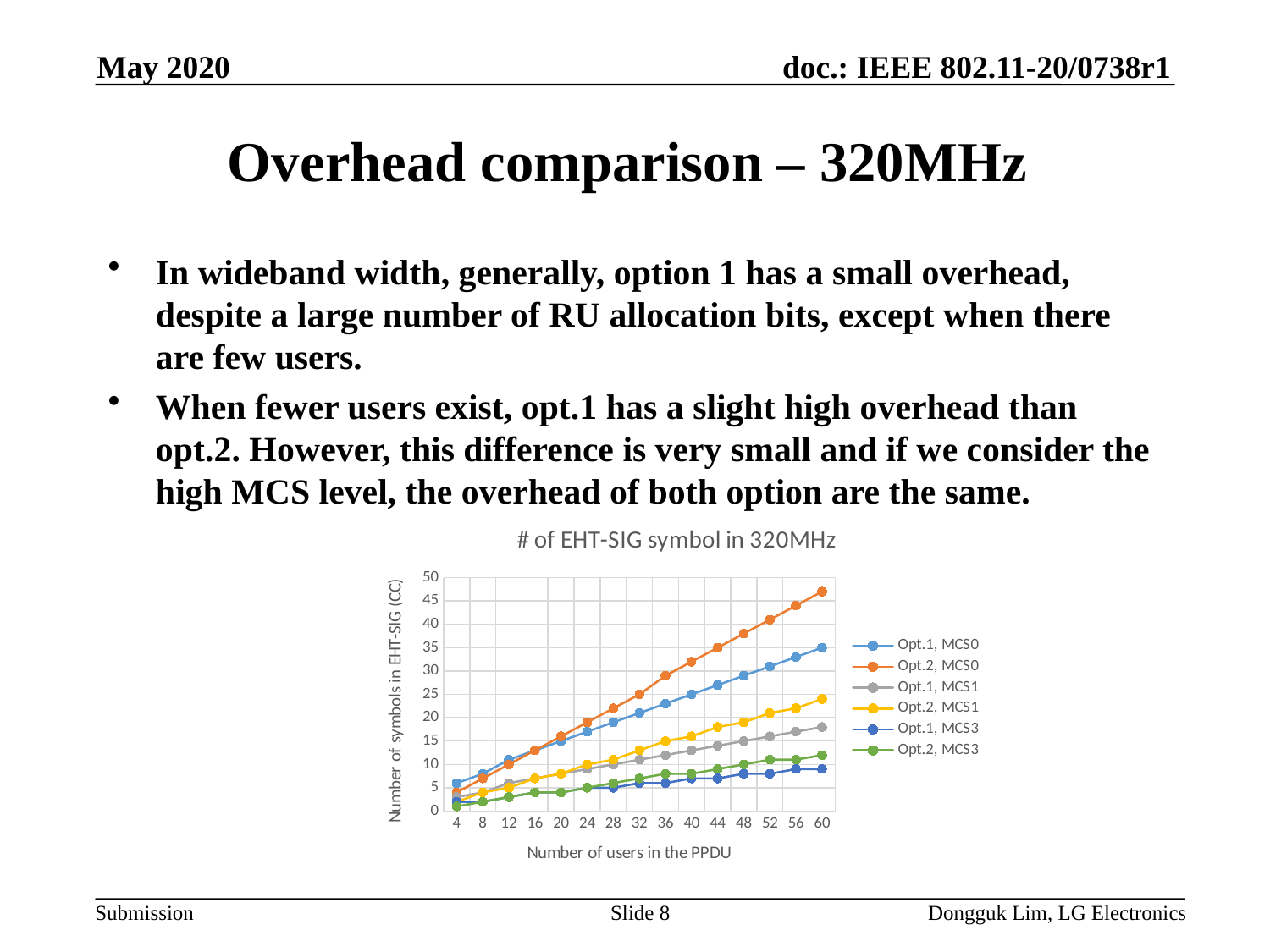
How many points along the x axis (number of users) are plotted for each series? 15 Is the value for Opt.2, MCS0 at 60 users greater or less than 45? greater Do the values for Opt.2, MCS0 rise or fall as the number of users increases? rise At 60 users, which is larger: Opt.1, MCS0 or Opt.2, MCS0? Opt.2, MCS0 Which series has the highest value at 60 users? Opt.2, MCS0 How many series does the legend list? 6 Is the value for Opt.2, MCS1 at 60 users greater or less than 20? greater Is the value for Opt.1, MCS3 at 60 users greater or less than 10? less What kind of chart is shown on the slide? line chart What is the title of the chart? # of EHT-SIG symbol in 320MHz Which series has the lowest value at 60 users? Opt.1, MCS3 What is the label of the x axis? Number of users in the PPDU